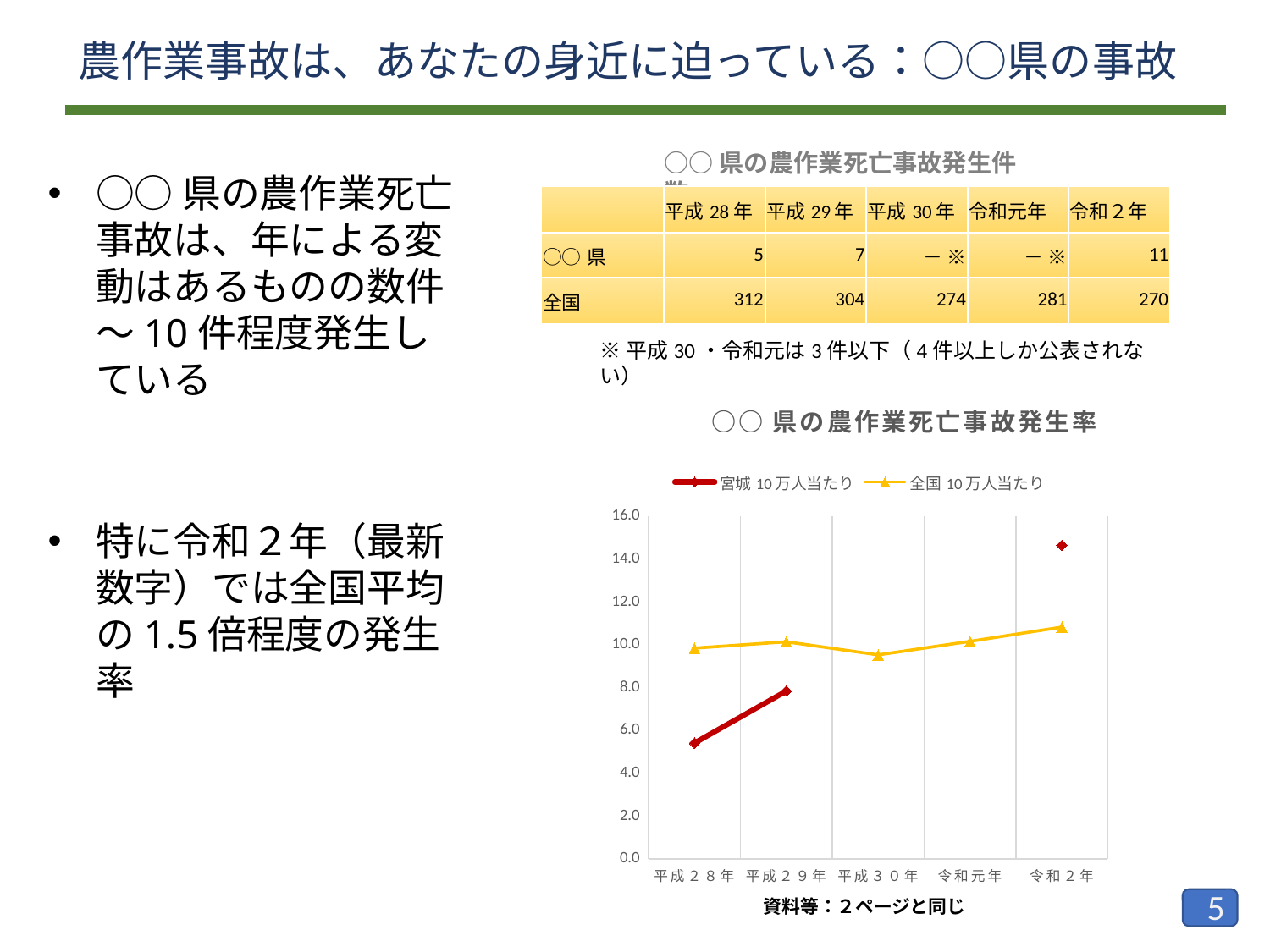
In which year is the value for 宮城 10万人当たり highest? 令和2年 In 令和2年, which series has the larger value, 宮城 10万人当たり or 全国 10万人当たり? 宮城 10万人当たり In 平成28年, which series has the larger value, 宮城 10万人当たり or 全国 10万人当たり? 全国 10万人当たり Is the value for 全国 10万人当たり in 平成30年 greater or less than 10.0? less What kind of chart is shown on the slide? line chart How many series does the legend of the chart list? 2 Which series is drawn in red in the chart? 宮城 10万人当たり Is the value for 宮城 10万人当たり in 平成28年 greater or less than 6.0? less Is the value for 宮城 10万人当たり in 令和2年 greater or less than 14.0? greater In which year is the value for 宮城 10万人当たり lowest? 平成28年 How many year categories are shown on the x axis of the chart? 5 What is the title of the chart? ○○県の農作業死亡事故発生率